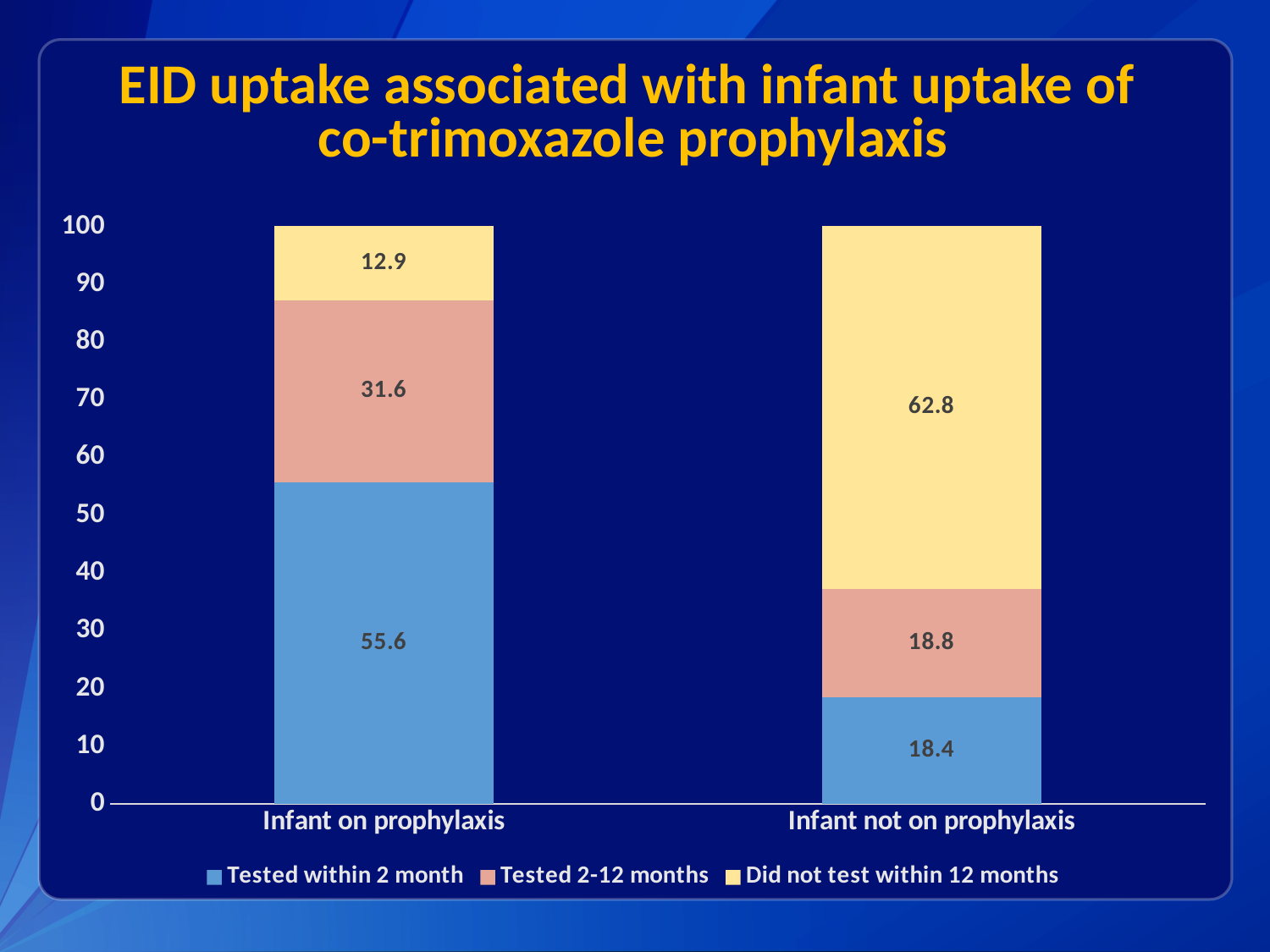
What is the value for "Tested 2-12 months" for Infant on prophylaxis? 31.6 How many series does the legend list? 3 Which category has the higher value for "Tested within 2 month"? Infant on prophylaxis What is the value for "Did not test within 12 months" for Infant on prophylaxis? 12.9 What is the value for "Tested within 2 month" for Infant on prophylaxis? 55.6 What is the value for "Tested within 2 month" for Infant not on prophylaxis? 18.4 What is the total of the stacked bar for Infant not on prophylaxis? 100 How many categories are shown on the x axis? 2 What is the value for "Did not test within 12 months" for Infant not on prophylaxis? 62.8 What is the difference between the "Did not test within 12 months" values for Infant not on prophylaxis and Infant on prophylaxis? 49.9 What kind of chart is shown on the slide? Stacked bar chart What is the difference between the "Tested within 2 month" values for Infant on prophylaxis and Infant not on prophylaxis? 37.2